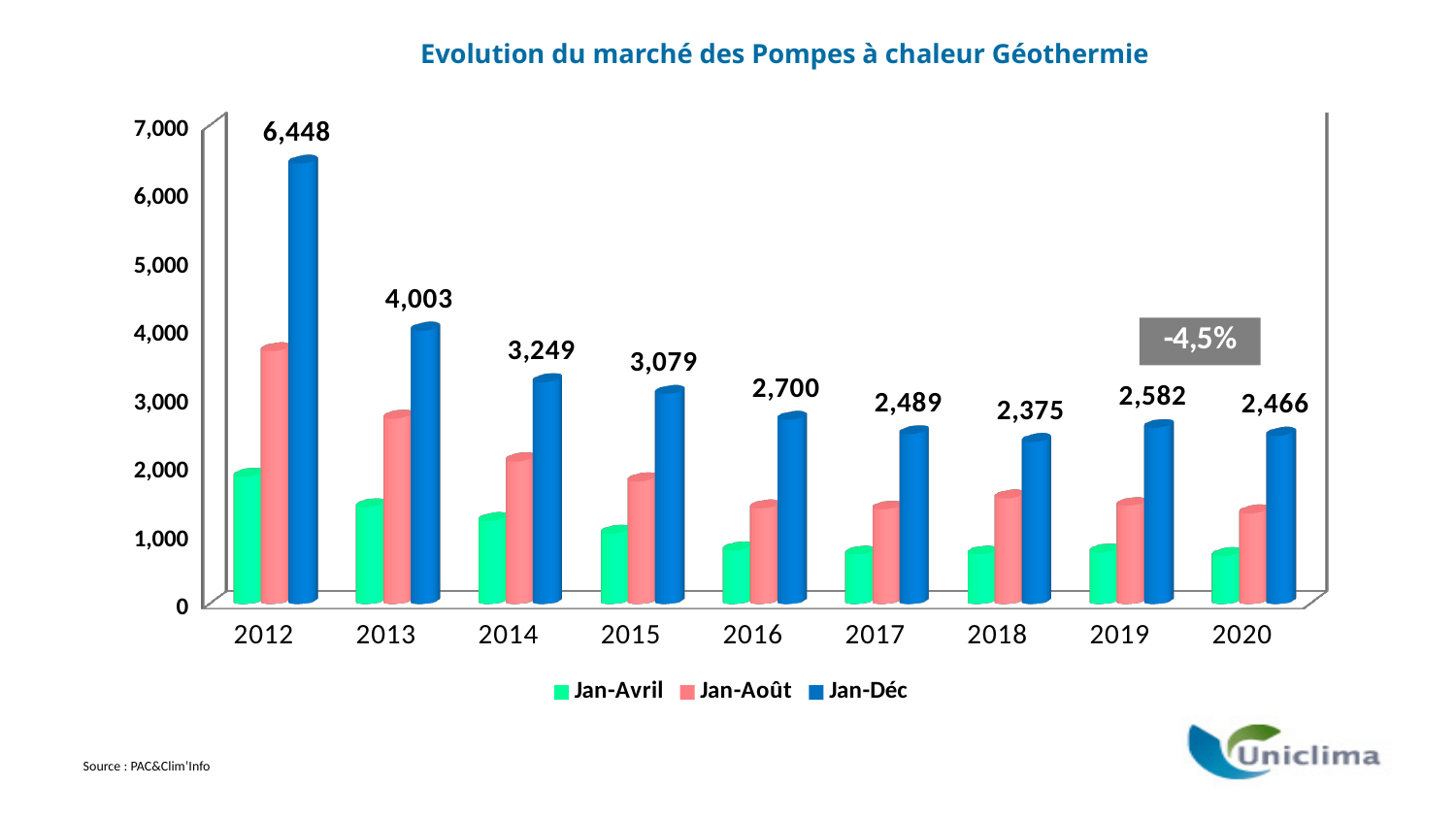
Which is larger, the Jan-Déc value for 2016 or for 2017? 2016 Is the Jan-Août value for 2012 greater or less than 3,000? greater Is the Jan-Avril value for 2020 greater or less than 1,000? less How many years are shown on the x axis? 9 What is the difference between the Jan-Déc values for 2019 and 2020? 116 How many series does the legend list? 3 What is the difference between the Jan-Déc values for 2012 and 2013? 2,445 What is the Jan-Déc value for 2012? 6,448 What is the Jan-Déc value for 2018? 2,375 What is the Jan-Déc value for 2020? 2,466 Which year has the lowest Jan-Déc value? 2018 Which year has the highest Jan-Déc value? 2012